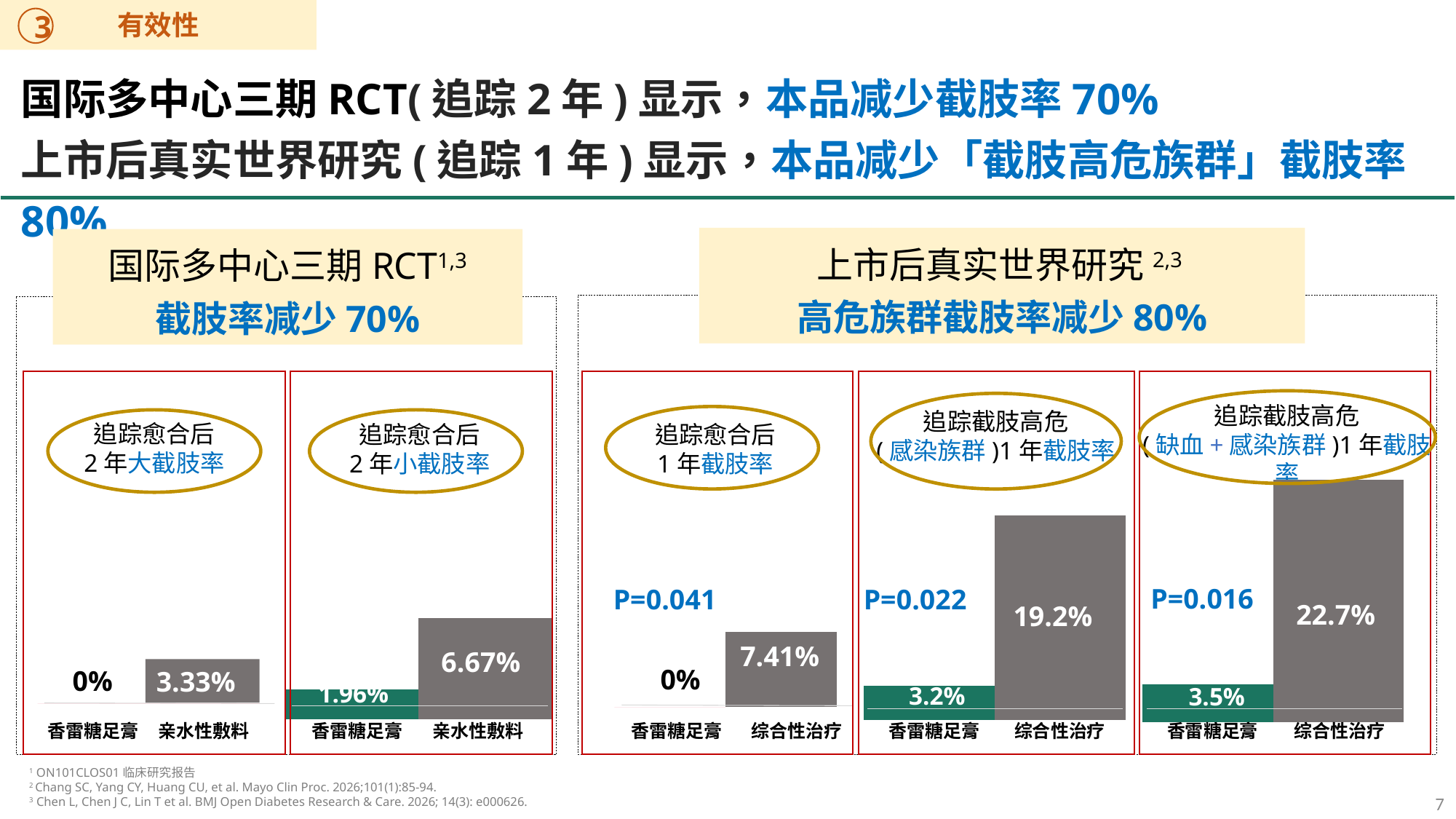
In the chart titled 追踪截肢高危(缺血+感染族群)1年截肢率, what is the value for 香雷糖足膏? 3.5% In the chart titled 追踪愈合后2年小截肢率, what is the value for 香雷糖足膏? 1.96% In the chart titled 追踪截肢高危(缺血+感染族群)1年截肢率, what is the difference between 综合性治疗 and 香雷糖足膏? 19.2% In the chart titled 追踪愈合后2年大截肢率, what is the value for 香雷糖足膏? 0% In the chart titled 追踪愈合后2年大截肢率, what is the value for 亲水性敷料? 3.33% How many categories are shown in the chart titled 追踪愈合后1年截肢率? 2 What kind of chart is the chart titled 追踪截肢高危(缺血+感染族群)1年截肢率? bar chart In the chart titled 追踪截肢高危(感染族群)1年截肢率, what is the value for 综合性治疗? 19.2% In the chart titled 追踪愈合后2年小截肢率, what is the difference between 亲水性敷料 and 香雷糖足膏? 4.71% In the chart titled 追踪愈合后1年截肢率, what is the value for 综合性治疗? 7.41% What P value is shown in the chart titled 追踪截肢高危(感染族群)1年截肢率? P=0.022 In the chart titled 追踪截肢高危(感染族群)1年截肢率, which category has the higher value, 香雷糖足膏 or 综合性治疗? 综合性治疗